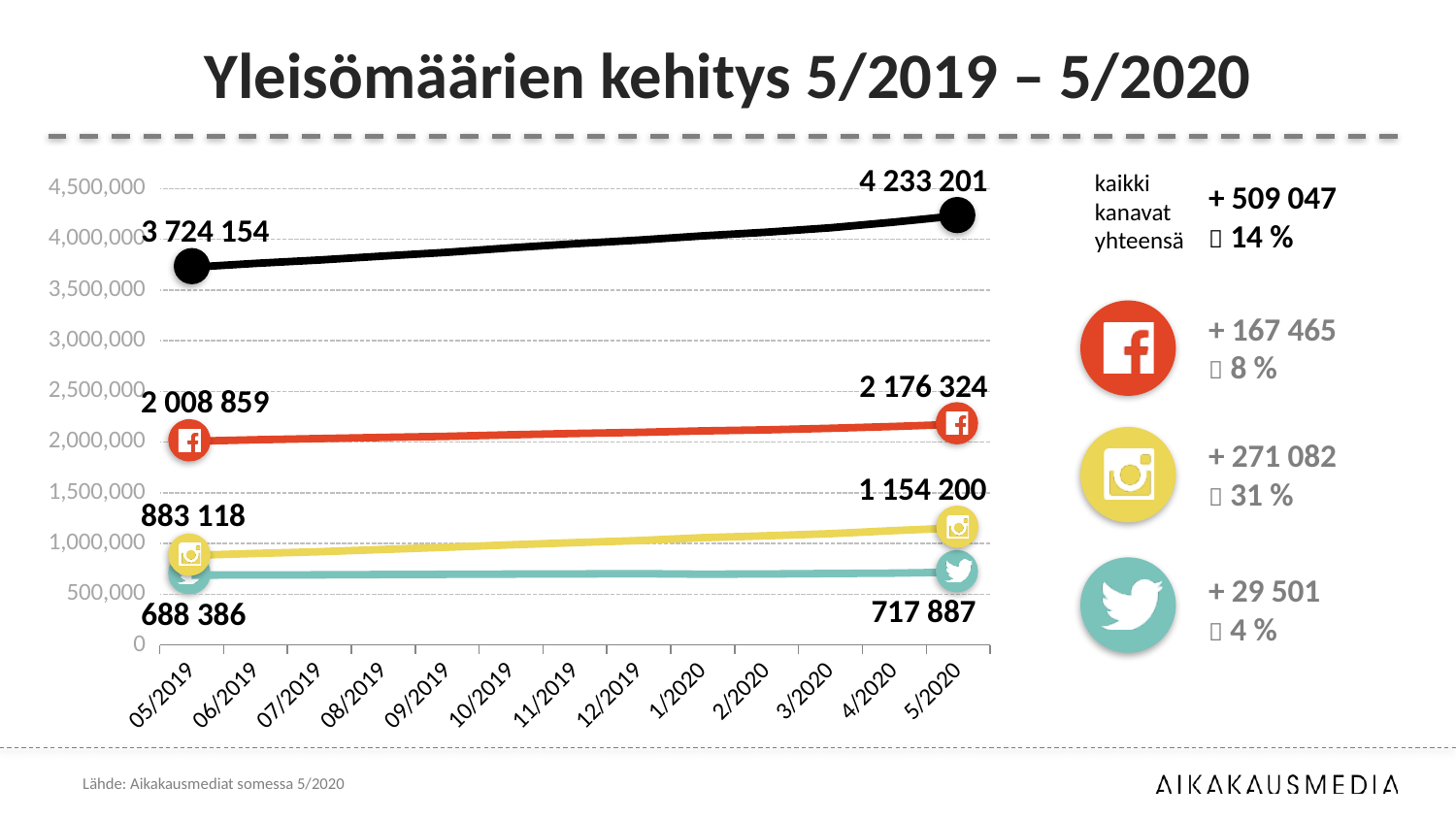
Does the Twitter line rise or fall from 05/2019 to 5/2020? rise What is the value of the Twitter line at 5/2020? 717 887 By how much did the Instagram line increase from 05/2019 to 5/2020? 271 082 Which line has the lowest value at 5/2020? Twitter What is the value of the black (total) line at 5/2020? 4 233 201 Which is larger at 05/2019: the Facebook value or the Instagram value? Facebook What type of chart is shown on the slide? line chart By how much did the Facebook line increase from 05/2019 to 5/2020? 167 465 What is the value of the Facebook line at 5/2020? 2 176 324 How many month labels are shown on the x axis? 13 What is the value of the black (total) line at 05/2019? 3 724 154 What is the value of the Instagram line at 05/2019? 883 118